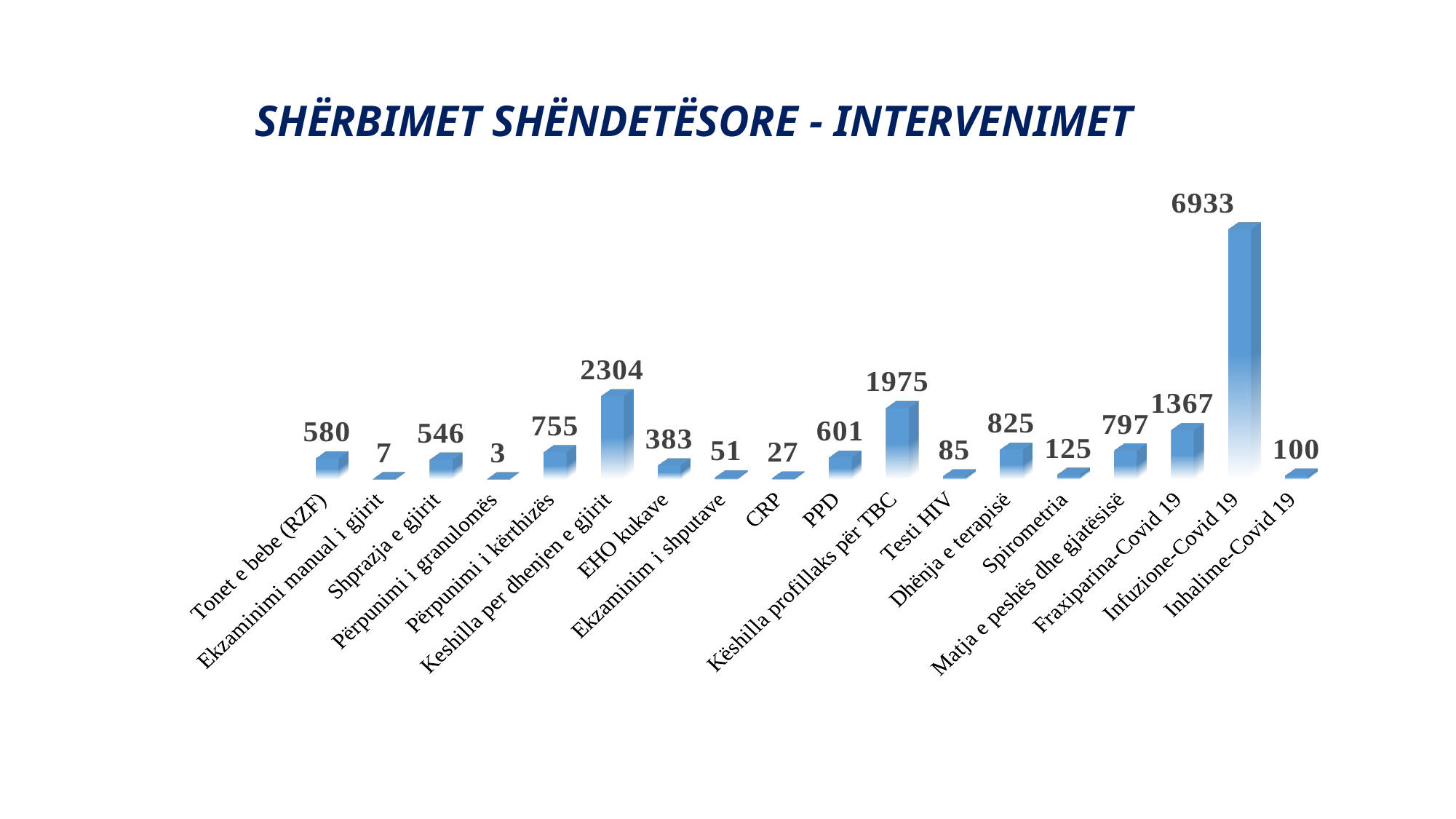
What is the difference between the values for Infuzione-Covid 19 and Keshilla per dhenjen e gjirit? 4629 What is the value for Infuzione-Covid 19? 6933 Which category has the highest value? Infuzione-Covid 19 What is the difference between the values for Dhënja e terapisë and Matja e peshës dhe gjatësisë? 28 What is the value for Testi HIV? 85 What kind of chart is shown on the slide? Bar chart What is the value for Keshilla per dhenjen e gjirit? 2304 What is the title of the chart? SHËRBIMET SHËNDETËSORE - INTERVENIMET Which category has the lowest value? Përpunimi i granulomës Which is larger, the value for PPD or the value for Tonet e bebe (RZF)? PPD What is the value for Fraxiparina-Covid 19? 1367 How many categories are shown in the chart? 18